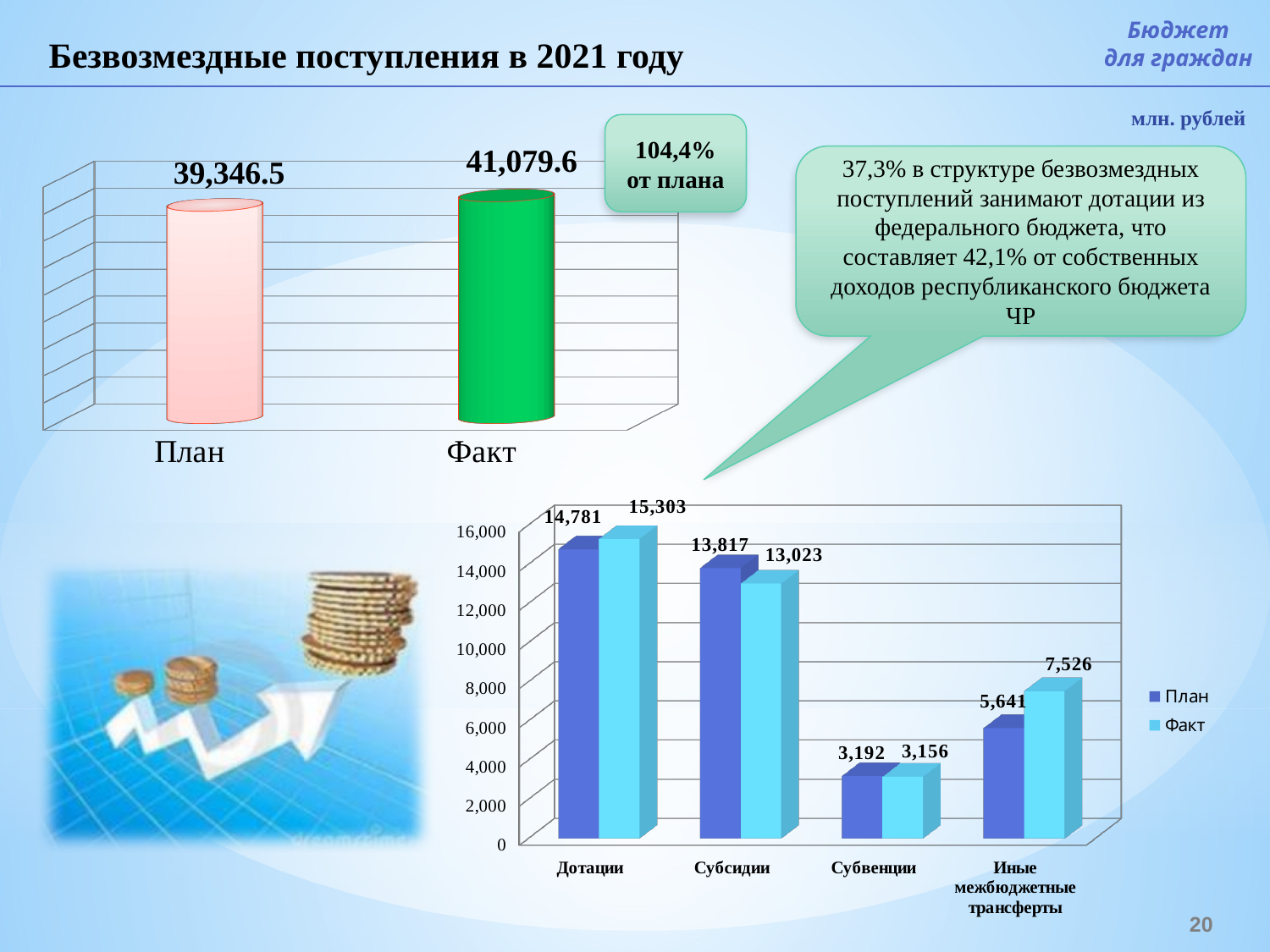
In the bottom-right bar chart, which category has the lowest Факт value? Субвенции In the bottom-right bar chart, which category has the highest План value? Дотации In the top-left chart, what is the value for План? 39,346.5 In the bottom-right bar chart, how many categories are shown on the x axis? 4 In the top-left chart, what is the value for Факт? 41,079.6 What type of chart is the bottom-right chart? Bar chart In the top-left chart, which is larger, План or Факт? Факт In the top-left chart, what is the difference between Факт and План? 1,733.1 In the bottom-right bar chart, what is the difference between Факт and План for Иные межбюджетные трансферты? 1,885 In the bottom-right bar chart, what is the Факт value for Дотации? 15,303 In the bottom-right bar chart, how many series does the legend list? 2 In the bottom-right bar chart, what is the План value for Субсидии? 13,817